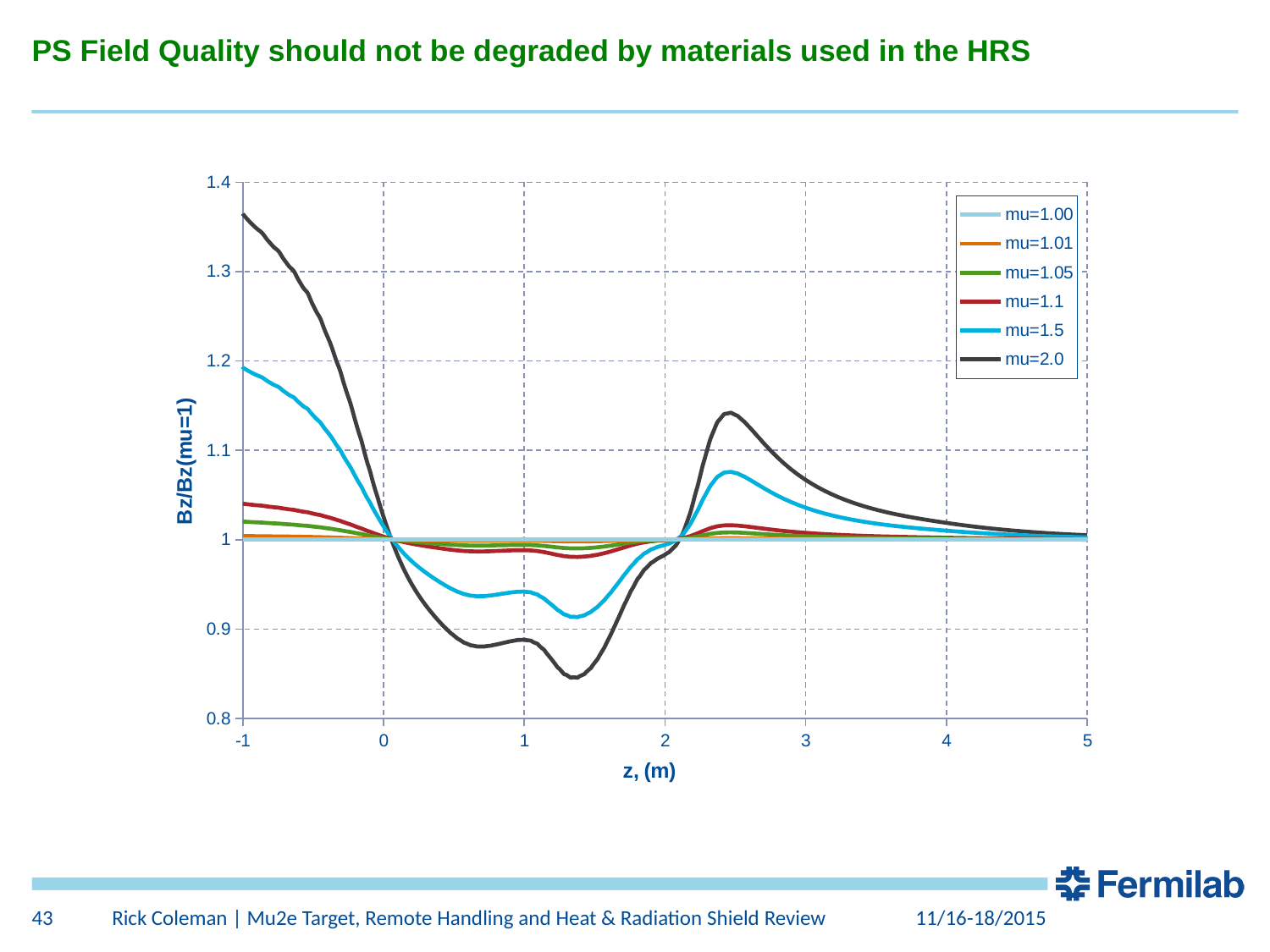
Is the value of the mu=2.0 curve at z = -1 greater or less than 1.3? greater Is the peak of the mu=2.0 curve near z = 2.5 greater or less than 1.1? greater What is the label of the x axis? z, (m) Is the peak of the mu=1.5 curve near z = 2.5 greater or less than 1.1? less What kind of chart is shown on the slide? line chart Which series deviates the most from 1 across the plotted range? mu=2.0 How many series does the legend list? 6 At z = -1, which curve has the larger value, mu=2.0 or mu=1.5? mu=2.0 Does the mu=1.5 curve rise or fall as z goes from 3 to 5? fall What is the label of the y axis? Bz/Bz(mu=1) Does the mu=2.0 curve rise or fall as z goes from -1 to 0? fall